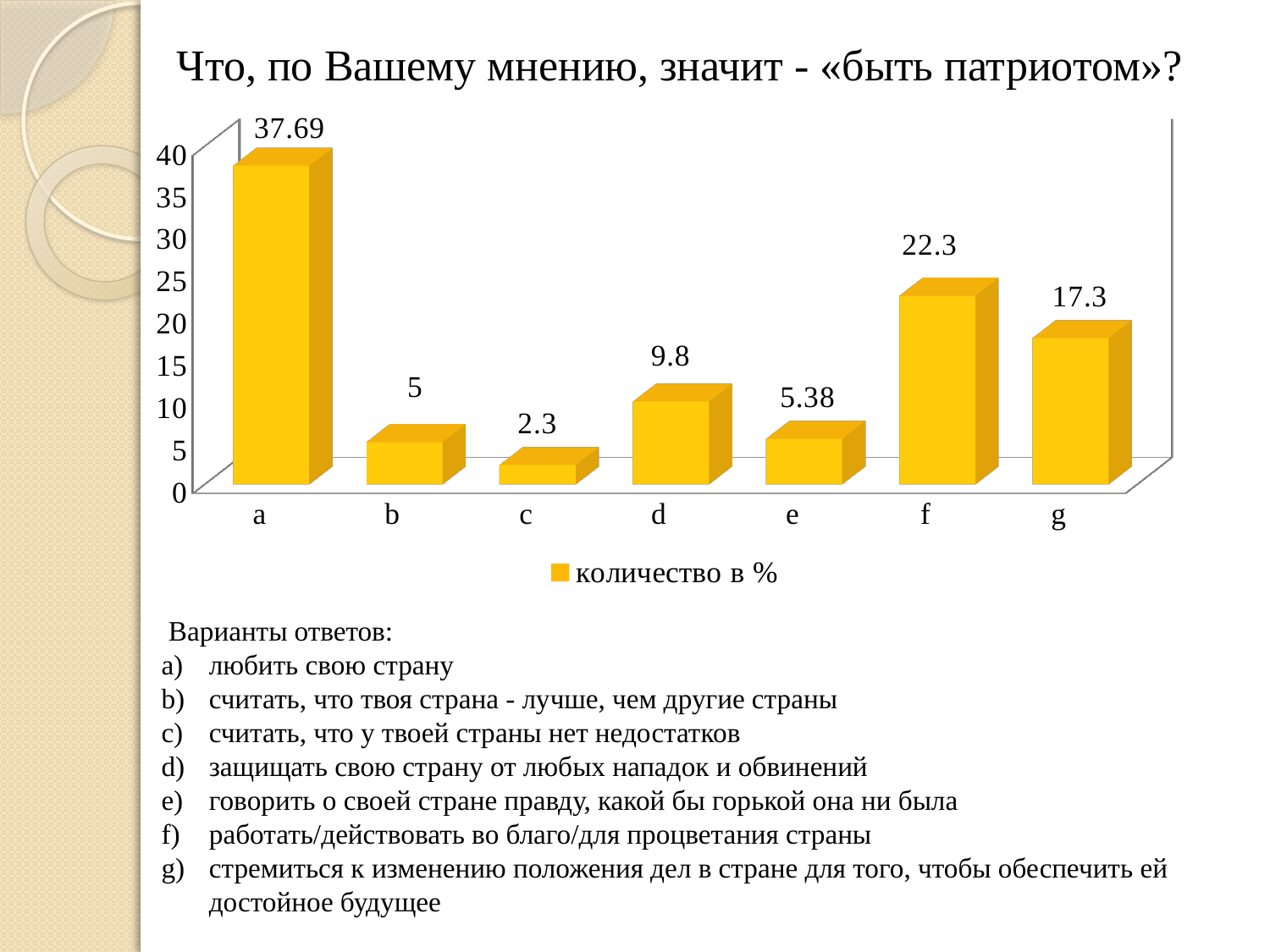
What kind of chart is shown on the slide? bar chart What is the legend entry for the series? количество в % What is the value for category e? 5.38 Which is larger, the value for d or the value for e? d Which category has the lowest value? c How many categories are shown on the x axis? 7 What is the value for category a? 37.69 Is the value for g greater or less than 15? greater What is the value for category c? 2.3 What is the value for category f? 22.3 What is the difference between the values for f and g? 5 Which category has the highest value? a